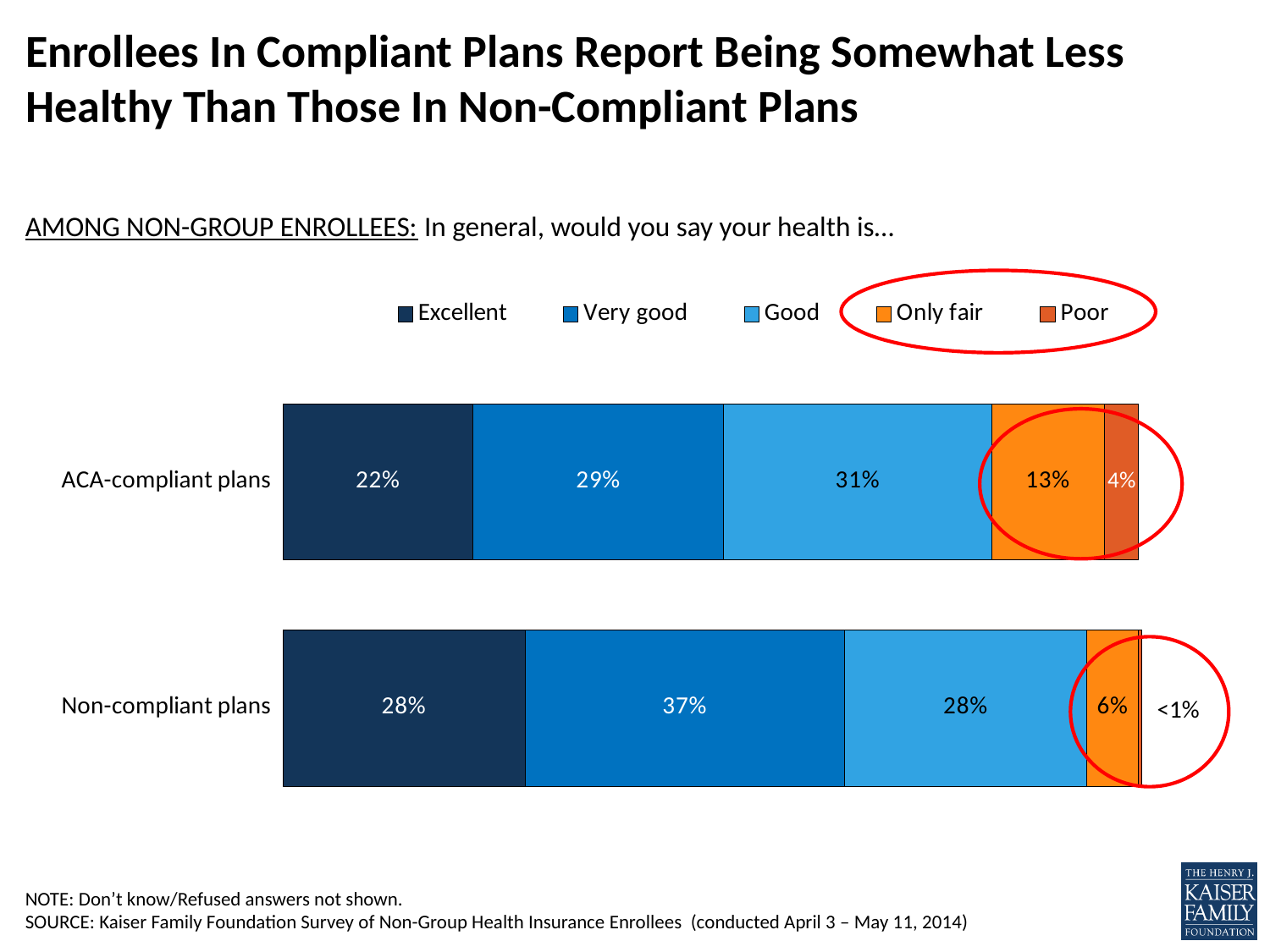
What kind of chart is shown on the slide? Stacked bar chart Which health rating has the largest share among Non-compliant plans? Very good What percentage of enrollees in ACA-compliant plans report their health as Only fair? 13% What value is shown for Poor among Non-compliant plans? <1% Which health rating has the largest share among ACA-compliant plans? Good What percentage of enrollees in ACA-compliant plans report their health as Excellent? 22% How many plan categories are shown in the chart? 2 What percentage of enrollees in Non-compliant plans report their health as Very good? 37% What is the total of the labeled segments in the ACA-compliant plans bar? 99% How many series does the legend list? 5 What is the difference between the Only fair shares for ACA-compliant plans and Non-compliant plans? 7 percentage points Which group has a larger share reporting Excellent health, ACA-compliant plans or Non-compliant plans? Non-compliant plans